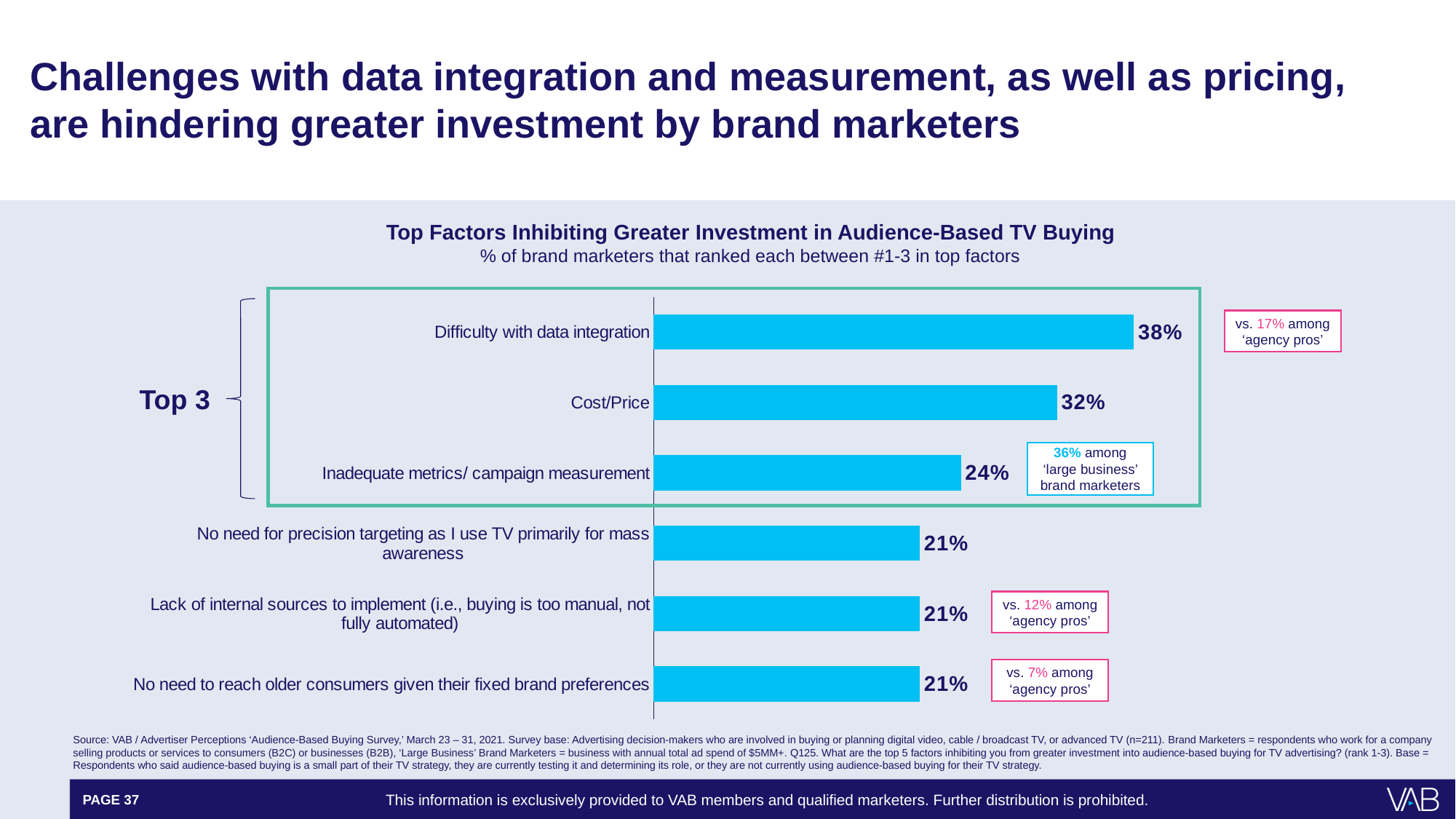
What is the difference between the values for 'Difficulty with data integration' and 'Cost/Price'? 6% What type of chart is shown on the slide? Bar chart How many factors (bars) are shown in the chart? 6 What is the title of the chart? Top Factors Inhibiting Greater Investment in Audience-Based TV Buying What is the value shown for 'Cost/Price'? 32% Which is larger: the value for 'Cost/Price' or for 'Inadequate metrics/ campaign measurement'? Cost/Price What is the difference between 'Cost/Price' and 'Inadequate metrics/ campaign measurement'? 8% How many factors are grouped under the 'Top 3' bracket? 3 What percentage is shown for 'Inadequate metrics/ campaign measurement'? 24% What percentage of brand marketers ranked 'Difficulty with data integration' among their top factors? 38% Which factor has the highest percentage in the chart? Difficulty with data integration What is the value for 'No need to reach older consumers given their fixed brand preferences'? 21%